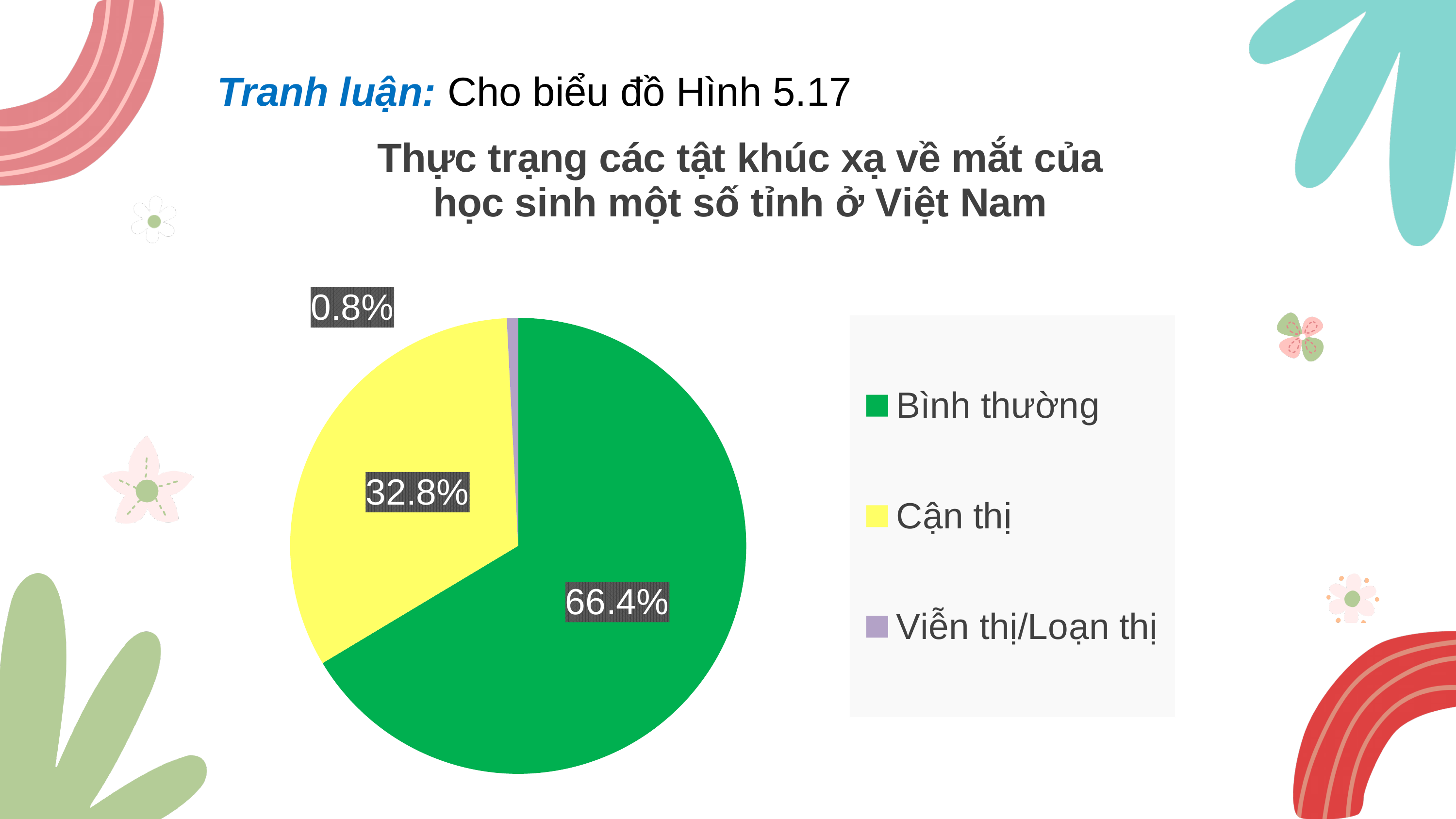
What is the combined percentage of the Cận thị and Viễn thị/Loạn thị slices? 33.6% How many categories does the pie chart show? 3 Which category has the largest slice of the pie chart? Bình thường What is the title of the chart? Thực trạng các tật khúc xạ về mắt của học sinh một số tỉnh ở Việt Nam What percentage of the pie chart is labelled Viễn thị/Loạn thị? 0.8% What percentage of the pie chart is labelled Cận thị? 32.8% What is the difference in percentage points between the Bình thường slice and the Cận thị slice? 33.6 Which category has the smallest slice of the pie chart? Viễn thị/Loạn thị What type of chart is shown on the slide? Pie chart What percentage of the pie chart is labelled Bình thường? 66.4% What colour is the Cận thị slice in the pie chart? Yellow Which slice is larger, Cận thị or Viễn thị/Loạn thị? Cận thị